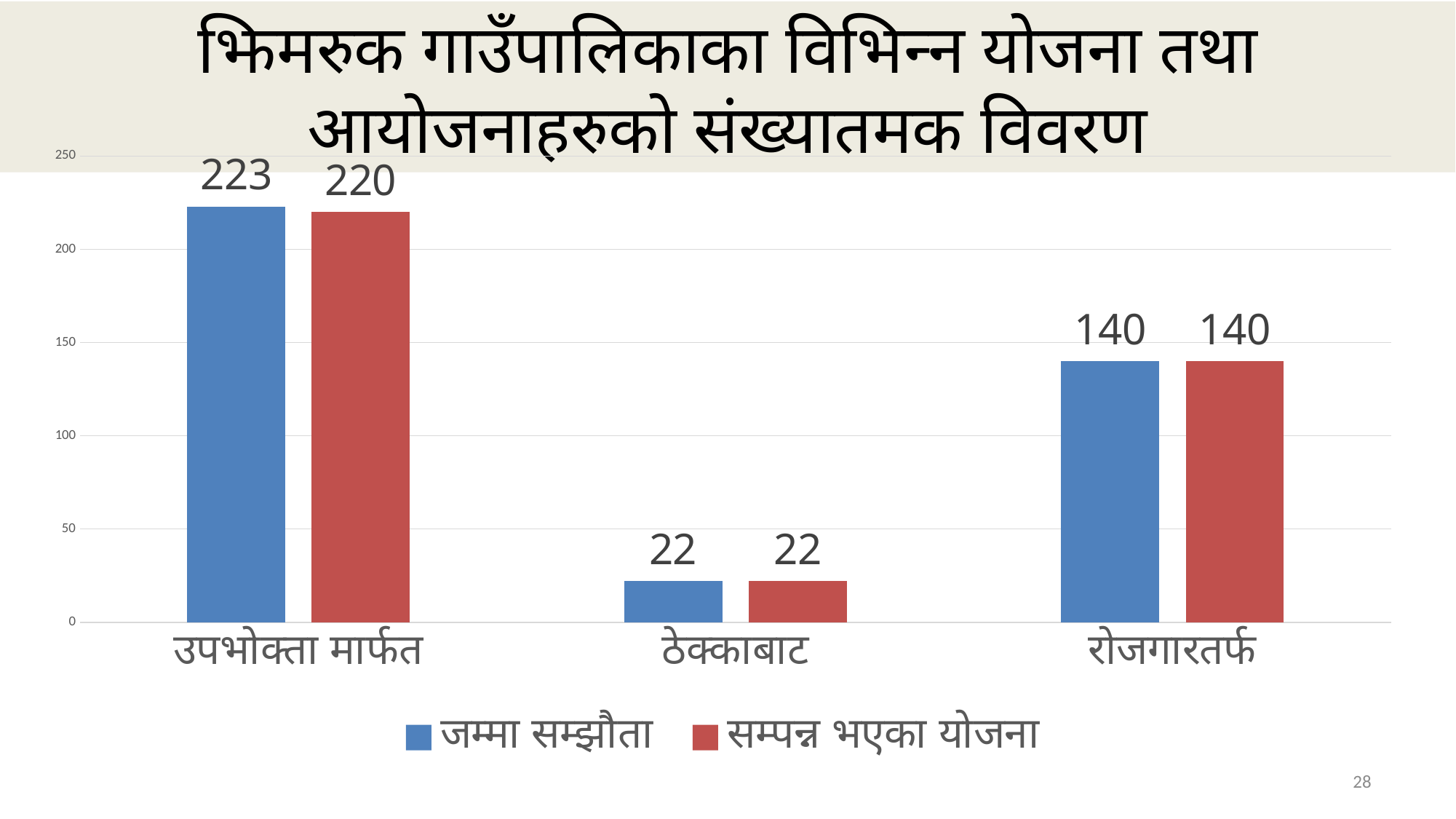
What is the value of सम्पन्न भएका योजना for उपभोक्ता मार्फत? 220 What is the value of सम्पन्न भएका योजना for रोजगारतर्फ? 140 Which category has the highest value for जम्मा सम्झौता? उपभोक्ता मार्फत How many series does the legend list? 2 How many categories are shown on the x axis? 3 What is the difference between जम्मा सम्झौता and सम्पन्न भएका योजना for उपभोक्ता मार्फत? 3 What is the value of जम्मा सम्झौता for ठेक्काबाट? 22 What kind of chart is shown on the slide? Bar chart Which is larger: जम्मा सम्झौता for रोजगारतर्फ or जम्मा सम्झौता for ठेक्काबाट? रोजगारतर्फ What is the value of जम्मा सम्झौता for उपभोक्ता मार्फत? 223 Which category has the lowest value for सम्पन्न भएका योजना? ठेक्काबाट What is the difference between the जम्मा सम्झौता values for उपभोक्ता मार्फत and रोजगारतर्फ? 83